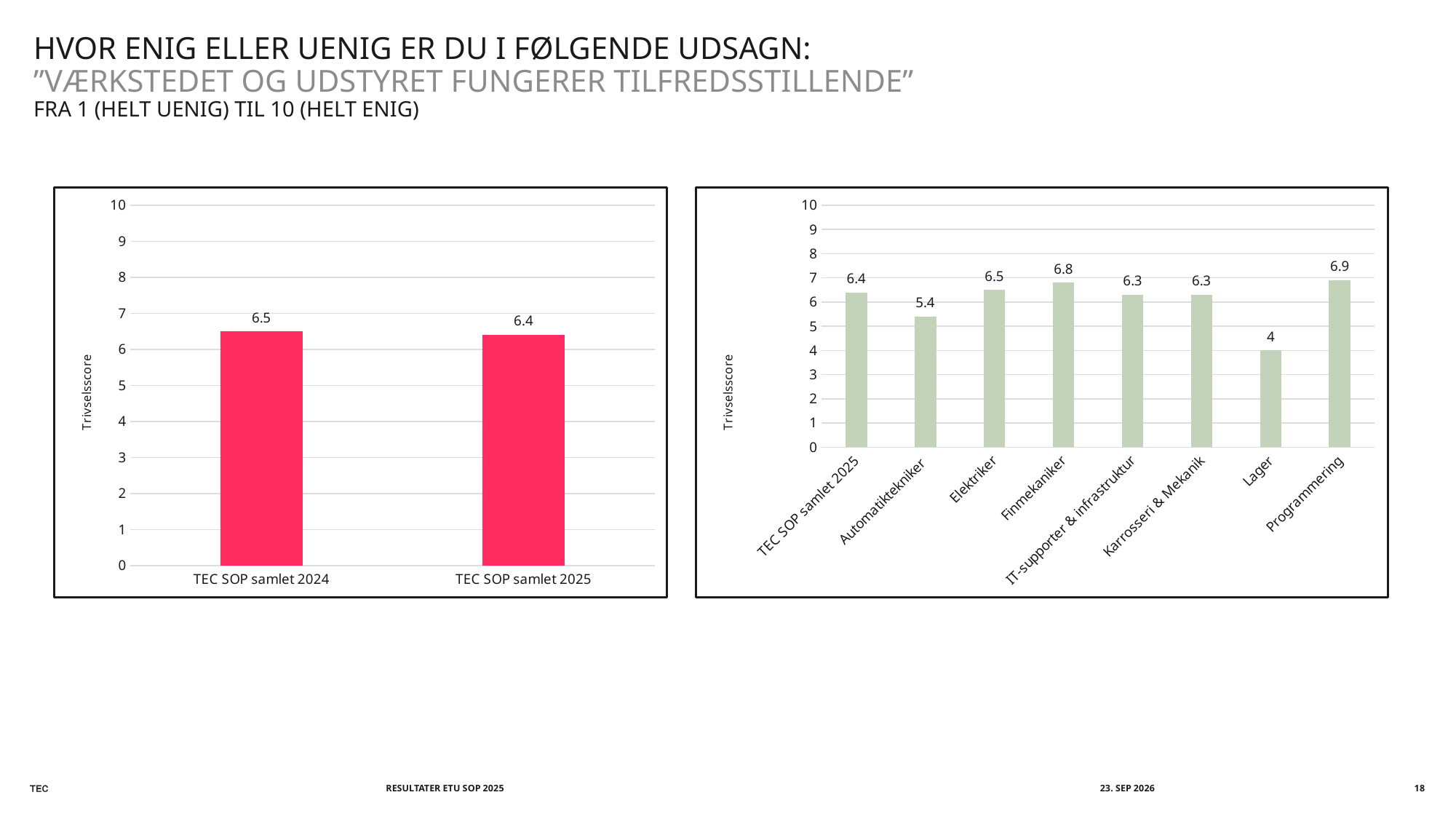
In the right chart, which category has the highest value? Programmering In the right chart, which category has the lowest value? Lager In the left chart, what is the difference between TEC SOP samlet 2024 and TEC SOP samlet 2025? 0.1 In the left chart, what is the value for TEC SOP samlet 2025? 6.4 In the right chart, what is the difference between Programmering and Lager? 2.9 In the left chart, do the values rise or fall from 2024 to 2025? fall In the right chart, which is larger, Automatiktekniker or Elektriker? Elektriker How many categories are shown in the right chart? 8 In the left chart, what is the value for TEC SOP samlet 2024? 6.5 What kind of chart is the right chart? bar chart In the right chart, what is the value for Lager? 4 In the right chart, what is the value for Finmekaniker? 6.8